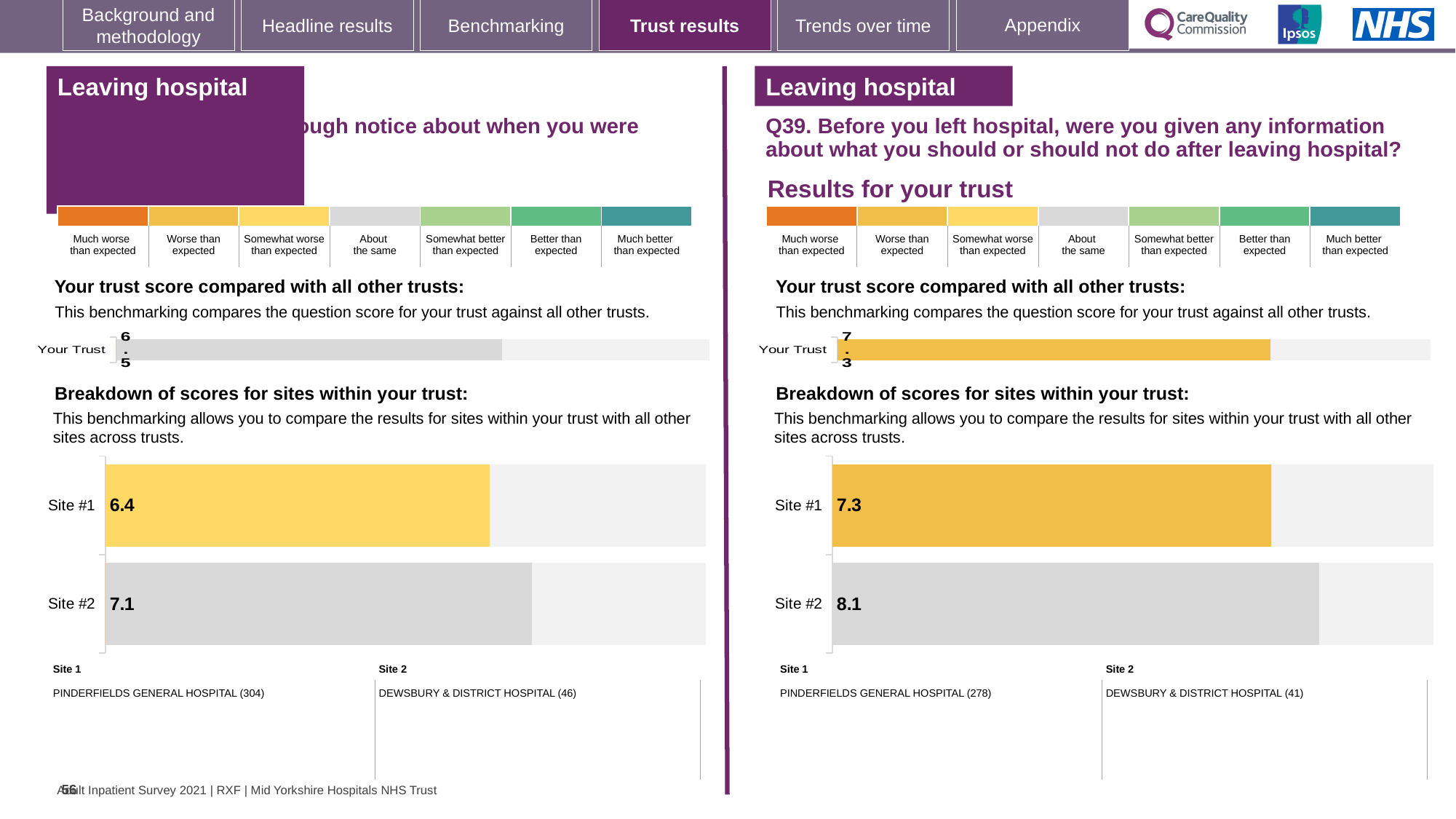
How many sites are shown in the site breakdown chart on the right-hand side (Q39)? 2 In the site breakdown chart on the left-hand side of the slide, which site has the lower score? Site #1 In the 'Breakdown of scores for sites within your trust' chart on the left-hand side of the slide, what is the score for Site #2? 7.1 In the 'Breakdown of scores for sites within your trust' chart on the right-hand side (Q39), what is the score for Site #2? 8.1 In the site breakdown chart on the left-hand side of the slide, what is the difference between the Site #2 and Site #1 scores? 0.7 In the 'Your trust score compared with all other trusts' chart on the right-hand side (Q39), what is the score shown for Your Trust? 7.3 In the site breakdown chart on the right-hand side (Q39), which site has the higher score? Site #2 In the 'Your trust score compared with all other trusts' chart on the left-hand side of the slide, what is the score shown for Your Trust? 6.5 In the site breakdown chart on the right-hand side (Q39), what is the difference between the Site #2 and Site #1 scores? 0.8 What type of chart is used for the site breakdown on the left-hand side of the slide? Bar chart In the 'Breakdown of scores for sites within your trust' chart on the left-hand side of the slide, what is the score for Site #1? 6.4 In the 'Breakdown of scores for sites within your trust' chart on the right-hand side (Q39), what is the score for Site #1? 7.3